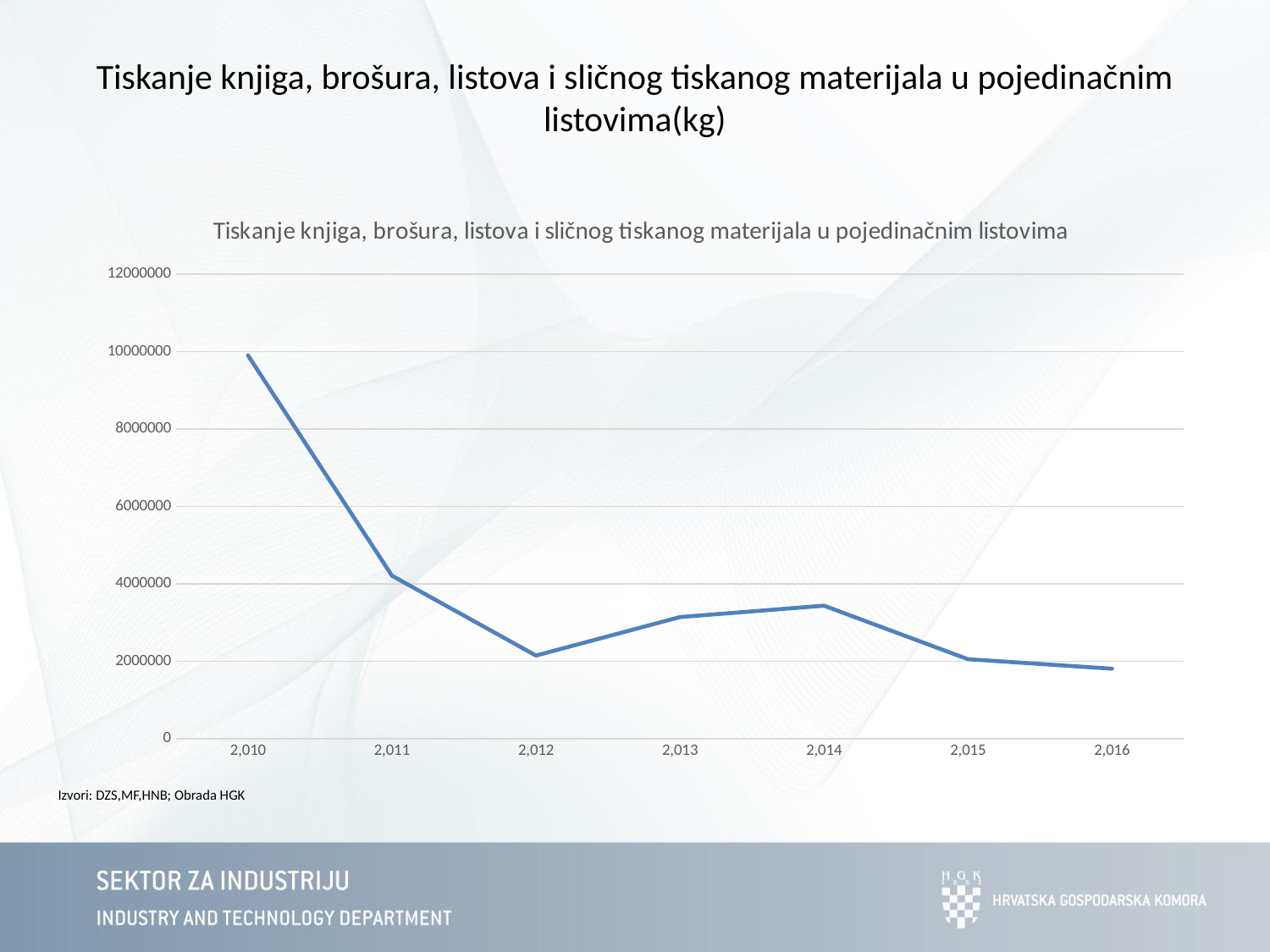
How many years are plotted along the x axis of the chart? 7 Which year has the highest value in the chart? 2,010 Which year has the lowest value in the chart? 2,016 Is the value for 2,014 greater or less than 4000000? less Is the value for 2,011 greater or less than 6000000? less Does the value overall rise or fall from 2,010 to 2,016? fall Is the value for 2,016 greater or less than 2000000? less Which year has the larger value, 2,012 or 2,014? 2,014 Which year has the larger value, 2,010 or 2,011? 2,010 What kind of chart is shown on the slide? line chart